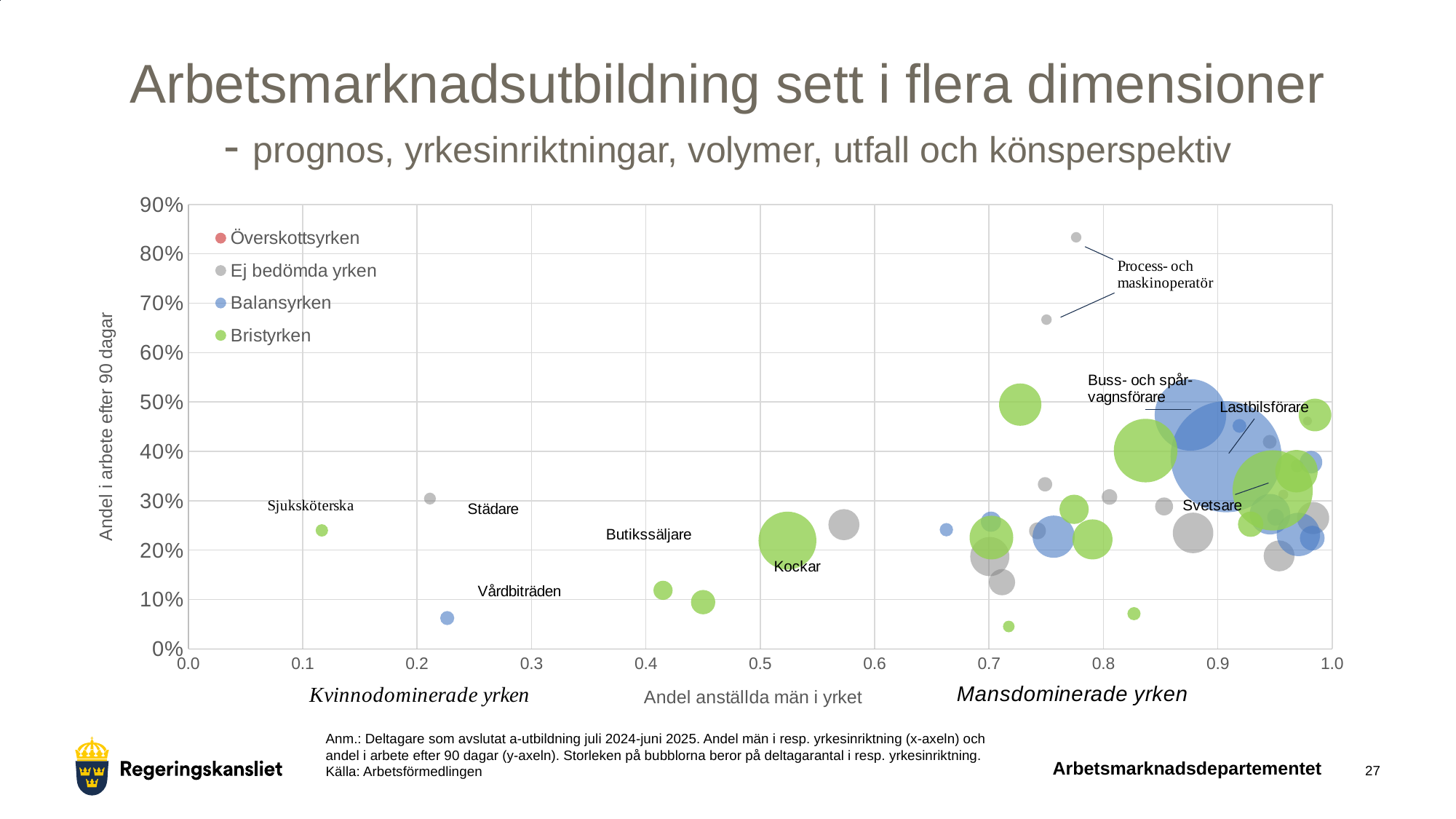
Is the share in work after 90 days for Vårdbiträden greater or less than 10%? less What is the label of the vertical axis? Andel i arbete efter 90 dagar Is the share in work after 90 days for Sjuksköterska greater or less than 20%? greater Is the share of employed men for Sjuksköterska greater or less than 0.2? less How many series does the legend list? 4 Which has a higher share in work after 90 days, Kockar or Lastbilsförare? Lastbilsförare Which series in the legend is shown in green? Bristyrken Which labelled occupation has the highest share in work after 90 days? Process- och maskinoperatör Which labelled occupation has the lowest share in work after 90 days? Vårdbiträden What kind of chart is shown on the slide? Bubble chart